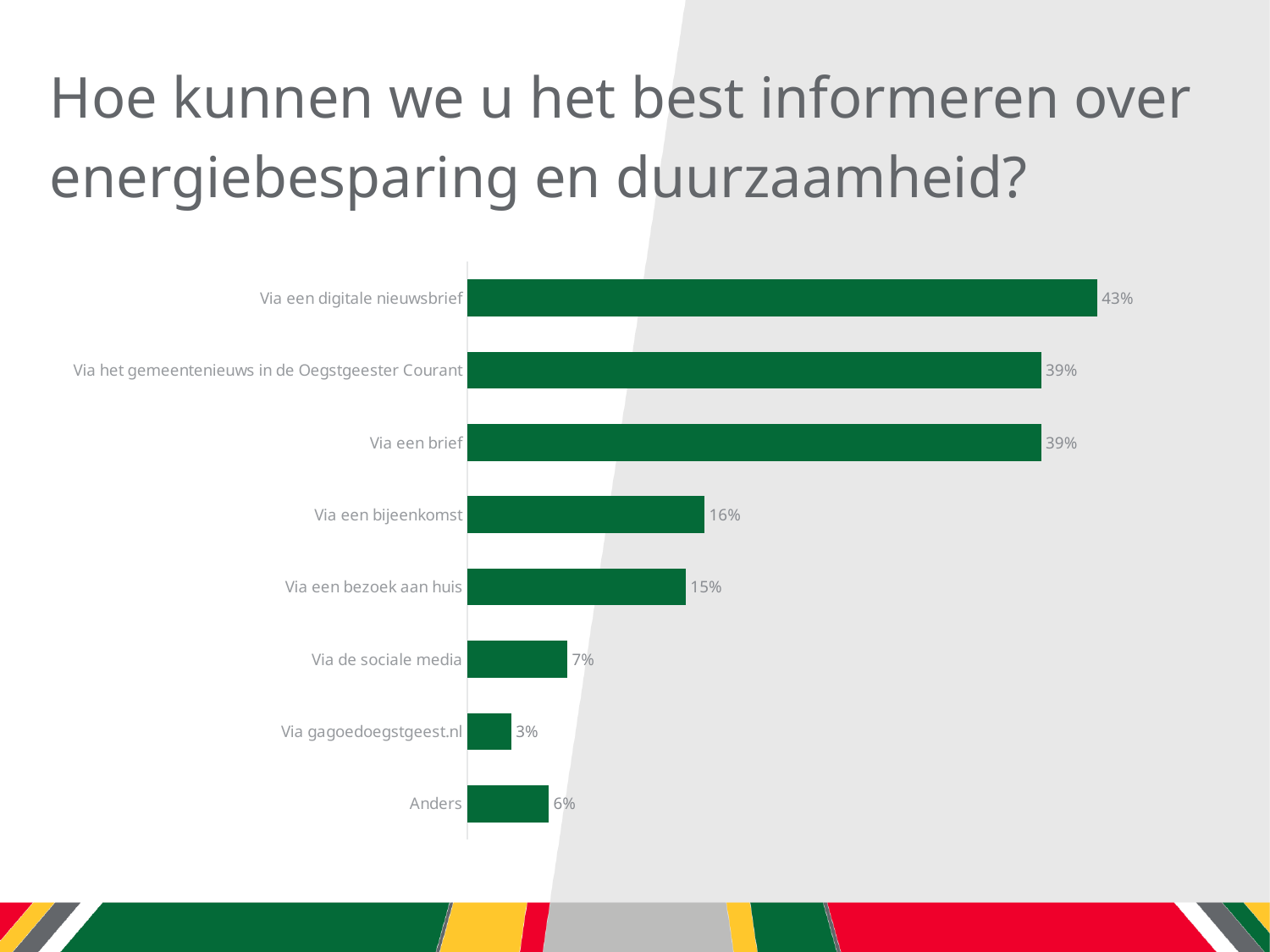
Which is larger, the value for "Via een bezoek aan huis" or the value for "Via de sociale media"? Via een bezoek aan huis How many categories are shown in the chart? 8 What is the title of the slide? Hoe kunnen we u het best informeren over energiebesparing en duurzaamheid? Which category has the lowest value? Via gagoedoegstgeest.nl What is the value for "Anders"? 6% What is the difference between the values for "Via een bijeenkomst" and "Via de sociale media"? 9% What is the value for "Via gagoedoegstgeest.nl"? 3% What is the value for "Via een digitale nieuwsbrief"? 43% What is the value for "Via een bijeenkomst"? 16% What kind of chart is shown on the slide? Bar chart What is the difference between the values for "Via een digitale nieuwsbrief" and "Via een brief"? 4% Which category has the highest value? Via een digitale nieuwsbrief